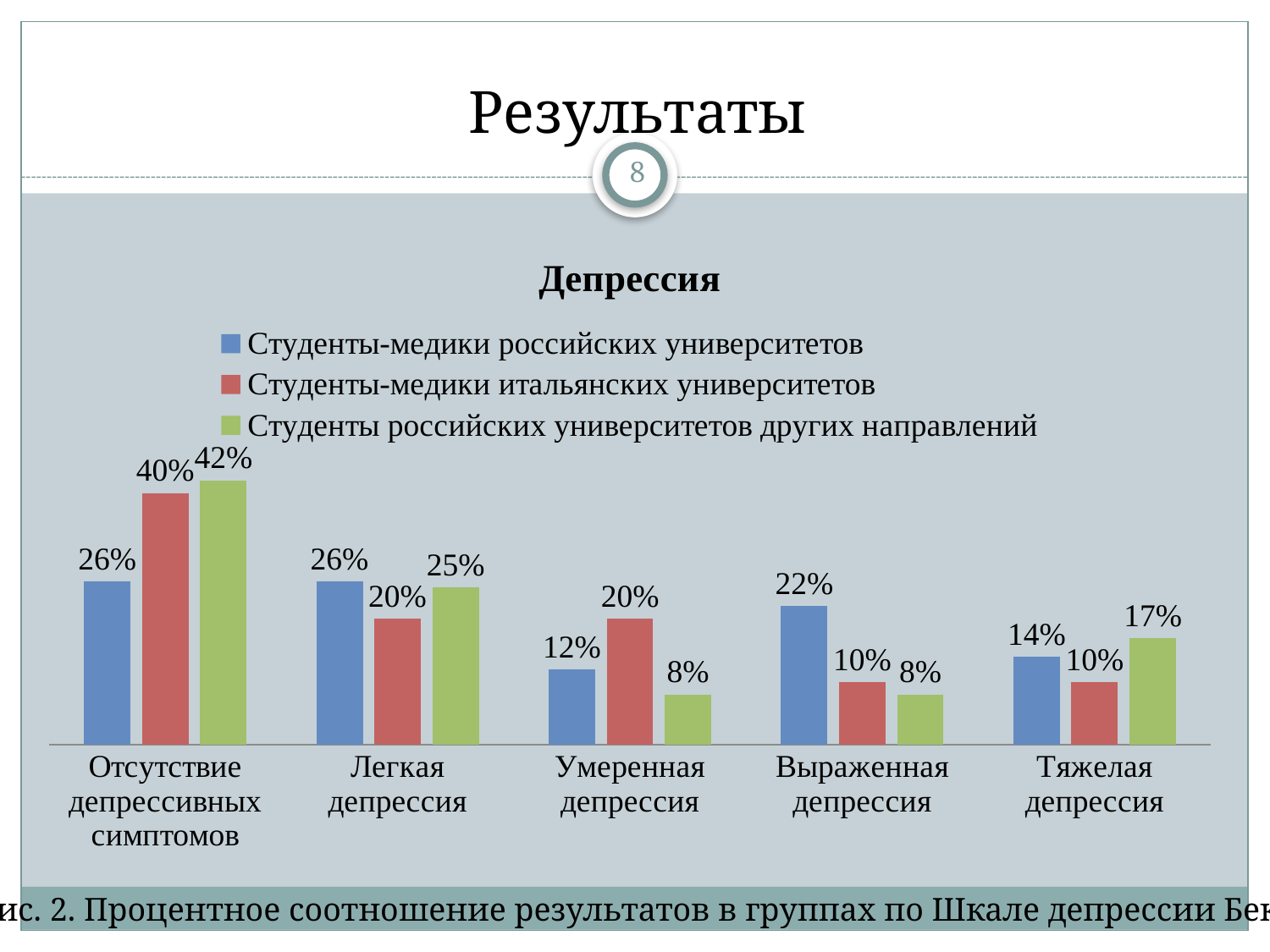
Which colour represents Студенты-медики итальянских университетов in the legend? Red In the Умеренная депрессия category, which series has the larger value: Студенты-медики итальянских университетов or Студенты-медики российских университетов? Студенты-медики итальянских университетов How many categories are shown on the x axis? 5 How many series does the legend list? 3 What is the value for Студенты-медики итальянских университетов in the Отсутствие депрессивных симптомов category? 40% What is the difference between the Студенты российских университетов других направлений value and the Студенты-медики российских университетов value in the Отсутствие депрессивных симптомов category? 16% Which category has the lowest value for Студенты-медики российских университетов? Умеренная депрессия What is the value for Студенты российских университетов других направлений in the Тяжелая депрессия category? 17% What is the value for Студенты-медики российских университетов in the Выраженная депрессия category? 22% What is the title of the chart? Депрессия Which category has the highest value for Студенты российских университетов других направлений? Отсутствие депрессивных симптомов What kind of chart is shown on the slide? Bar chart